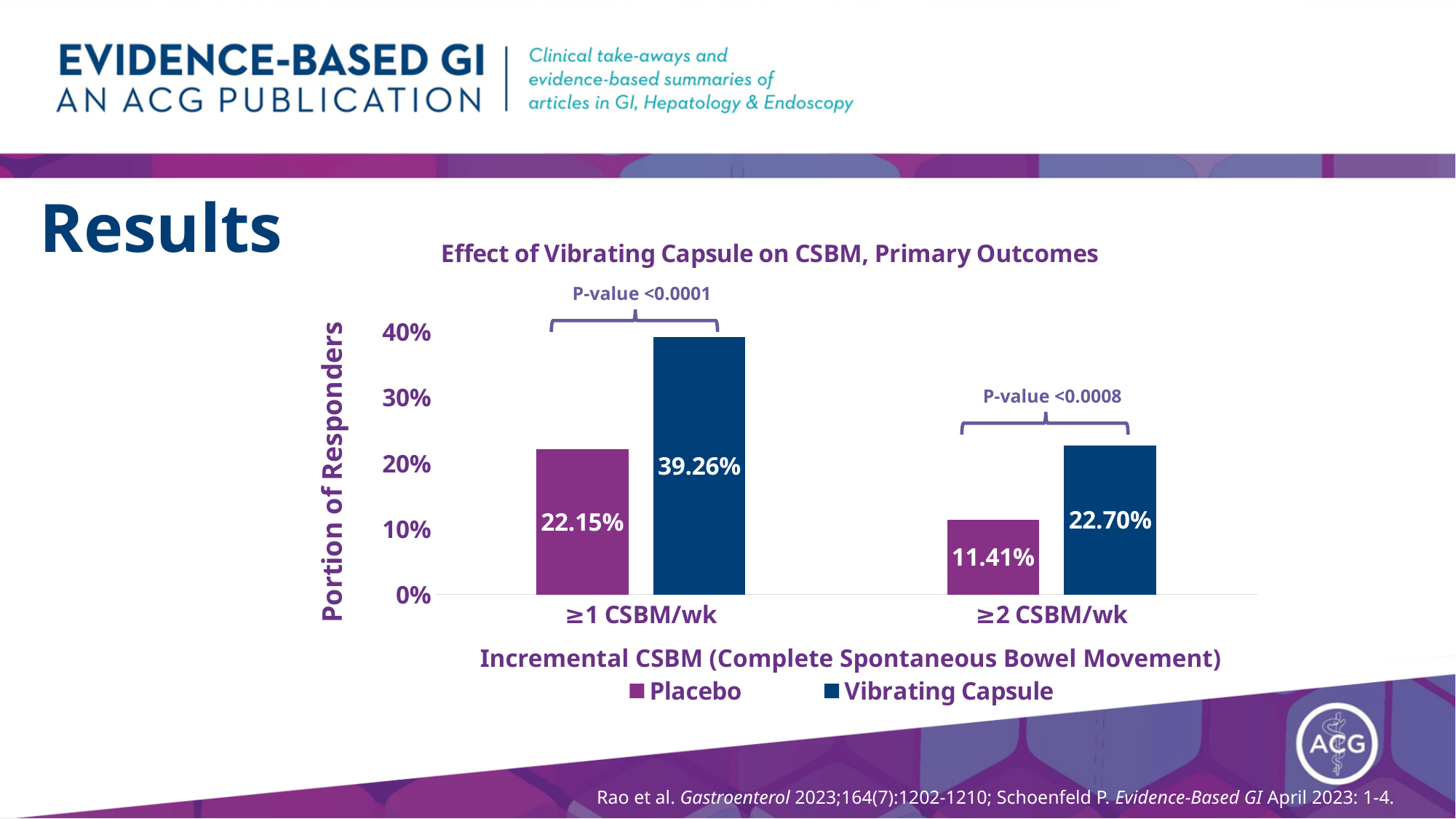
Which is larger: Placebo at ≥1 CSBM/wk or Vibrating Capsule at ≥2 CSBM/wk? Vibrating Capsule at ≥2 CSBM/wk What is the title of the chart? Effect of Vibrating Capsule on CSBM, Primary Outcomes What is the value for Placebo at ≥2 CSBM/wk? 11.41% What is the difference between Vibrating Capsule and Placebo at ≥1 CSBM/wk? 17.11% Which bar has the lowest value on the chart? Placebo at ≥2 CSBM/wk What is the value for Placebo at ≥1 CSBM/wk? 22.15% What is the difference between Vibrating Capsule and Placebo at ≥2 CSBM/wk? 11.29% How many series does the legend list? 2 What is the value for Vibrating Capsule at ≥1 CSBM/wk? 39.26% Which bar has the highest value on the chart? Vibrating Capsule at ≥1 CSBM/wk What is the value for Vibrating Capsule at ≥2 CSBM/wk? 22.70% What kind of chart is shown on the slide? Bar chart